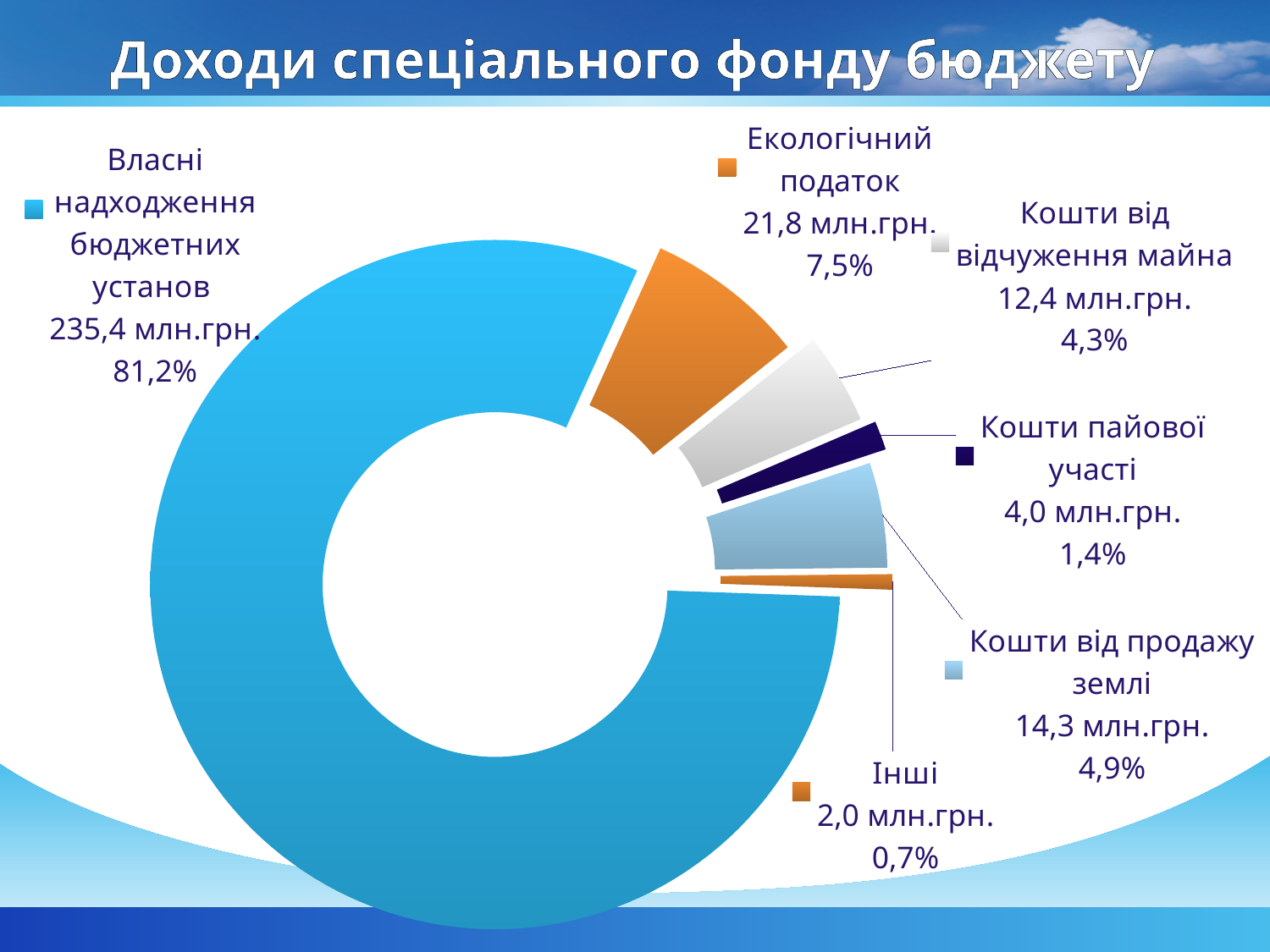
What is the difference between Екологічний податок and Кошти від продажу землі? 7,5 млн.грн. What is the title of the slide's chart? Доходи спеціального фонду бюджету What share of the total does Кошти пайової участі represent? 1,4% Which category has the smallest value? Інші Which is larger, Кошти від продажу землі or Кошти від відчуження майна? Кошти від продажу землі How many categories does the chart show? 6 What share of the total does Кошти від відчуження майна represent? 4,3% What is the value for Кошти від продажу землі? 14,3 млн.грн. What kind of chart is shown on the slide? doughnut chart What is the value for Власні надходження бюджетних установ? 235,4 млн.грн. What is the value for Екологічний податок? 21,8 млн.грн. Which category has the largest value? Власні надходження бюджетних установ